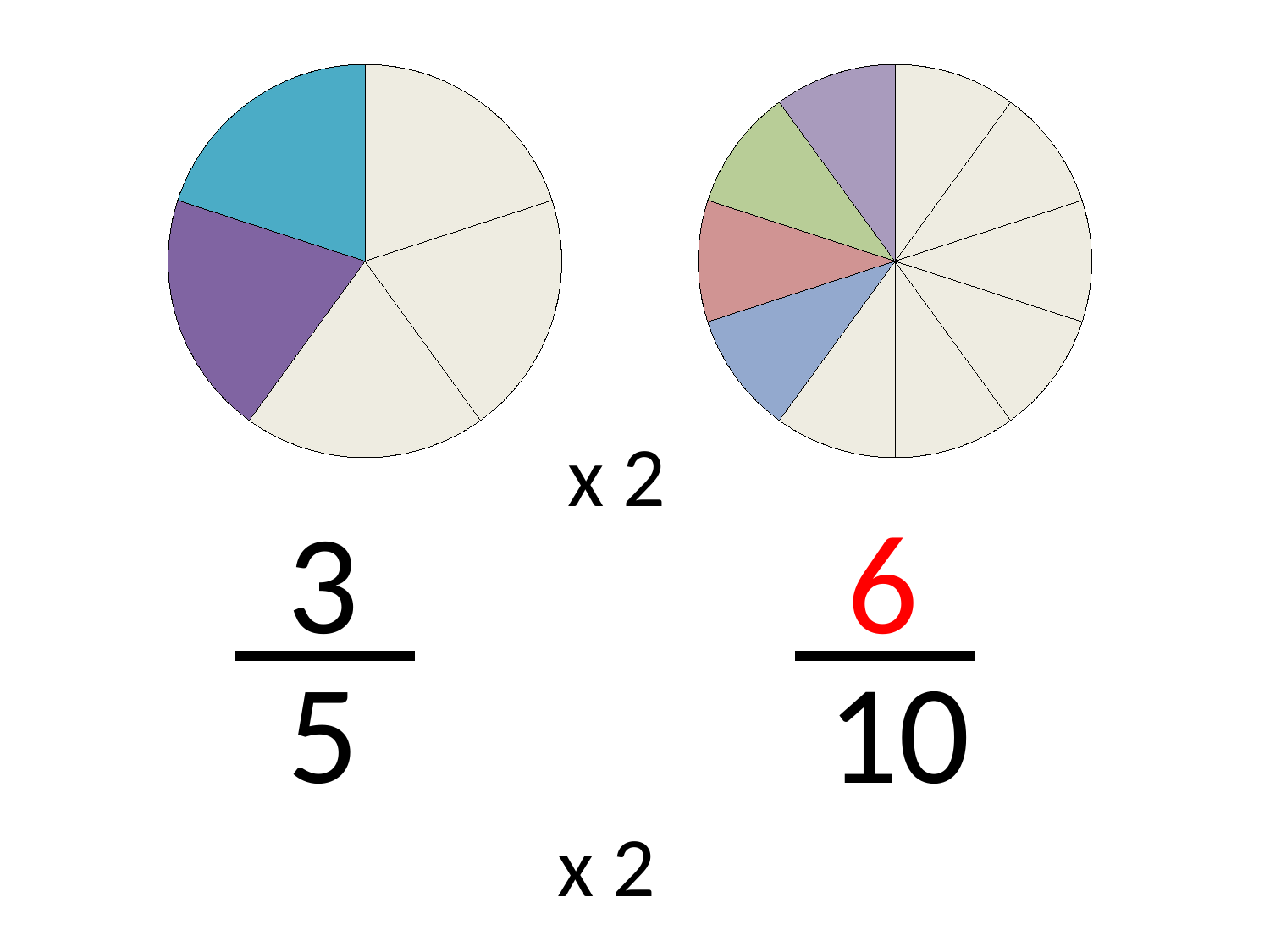
What fraction is written below the left pie chart? 3/5 How many slices does the left pie chart have? 5 How many charts are shown on the slide? 2 How many slices does the right pie chart have? 10 How many more slices does the right pie chart have than the left pie chart? 5 Which pie chart has more slices, the left one or the right one? the right one What fraction is written below the right pie chart? 6/10 What kind of chart is the left chart on the slide? pie chart